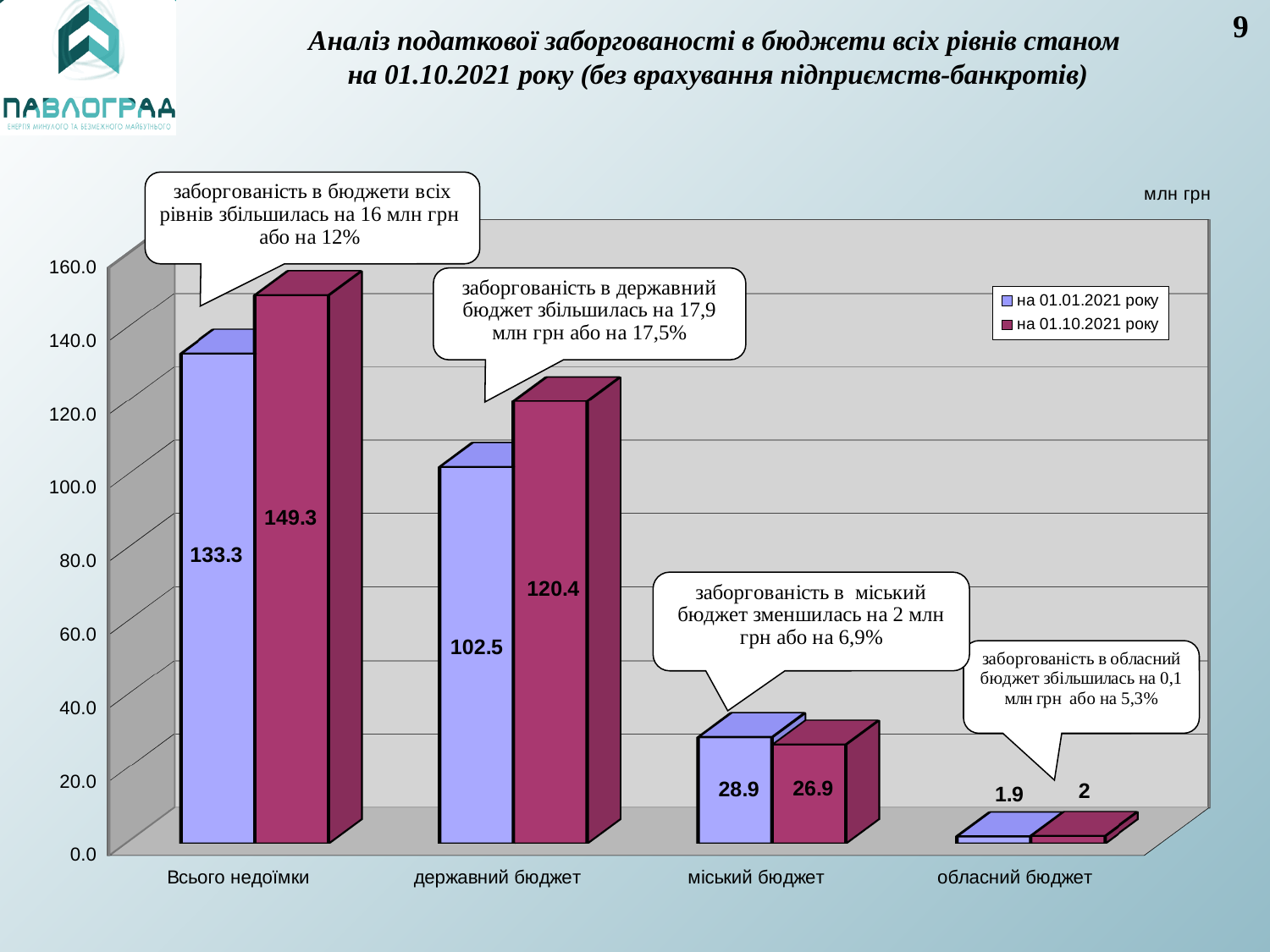
How many series does the legend list? 2 What is the value for "міський бюджет" in the "на 01.01.2021 року" series? 28.9 For "державний бюджет", which series has the larger value: "на 01.01.2021 року" or "на 01.10.2021 року"? на 01.10.2021 року What is the value for "державний бюджет" in the "на 01.10.2021 року" series? 120.4 Which category has the lowest value in the "на 01.01.2021 року" series? обласний бюджет What is the difference between the "на 01.01.2021 року" and "на 01.10.2021 року" values for "міський бюджет"? 2 Is the value for "державний бюджет" in the "на 01.01.2021 року" series greater or less than 100.0? greater What is the difference between the "на 01.10.2021 року" and "на 01.01.2021 року" values for "Всього недоїмки"? 16 Which category has the highest value in the "на 01.10.2021 року" series? Всього недоїмки What kind of chart is shown on the slide? bar chart What is the value for "обласний бюджет" in the "на 01.10.2021 року" series? 2 How many categories are shown on the x axis? 4